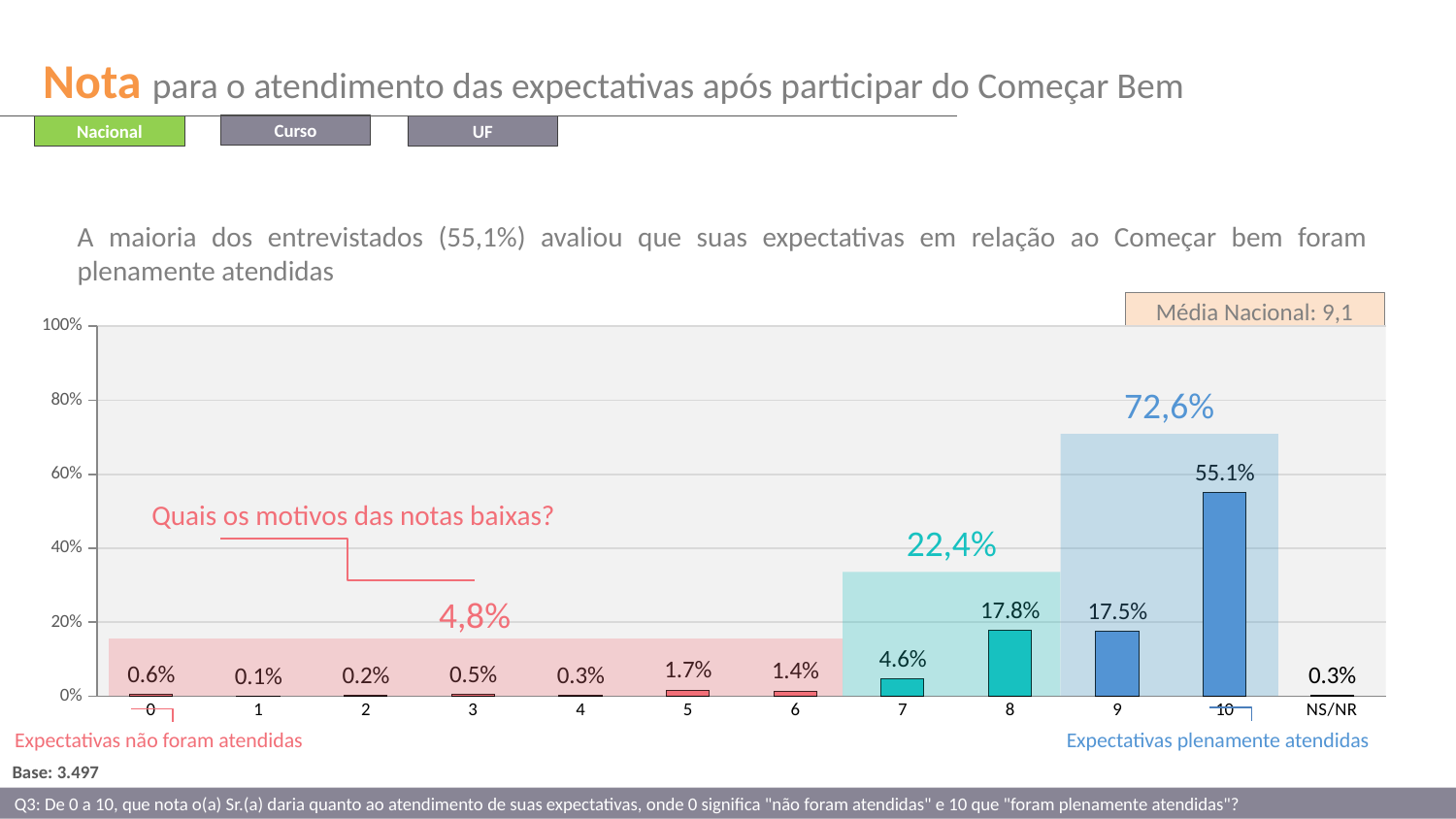
What percentage of respondents gave a score of 10? 55.1% What is the combined percentage shown for scores 9 and 10 (the 'Expectativas plenamente atendidas' group)? 72,6% Which score category has the lowest percentage? 1 What is the difference between the percentages for scores 10 and 9? 37.6% What percentage of respondents gave a score of 8? 17.8% Which score category has the highest percentage? 10 Which is larger, the percentage for score 5 or for score 6? 5 Is the value for score 10 greater or less than 40%? greater What is the value shown for the NS/NR category? 0.3% How many categories are shown on the x axis? 12 What type of chart is shown on the slide? bar chart What percentage of respondents gave a score of 7? 4.6%